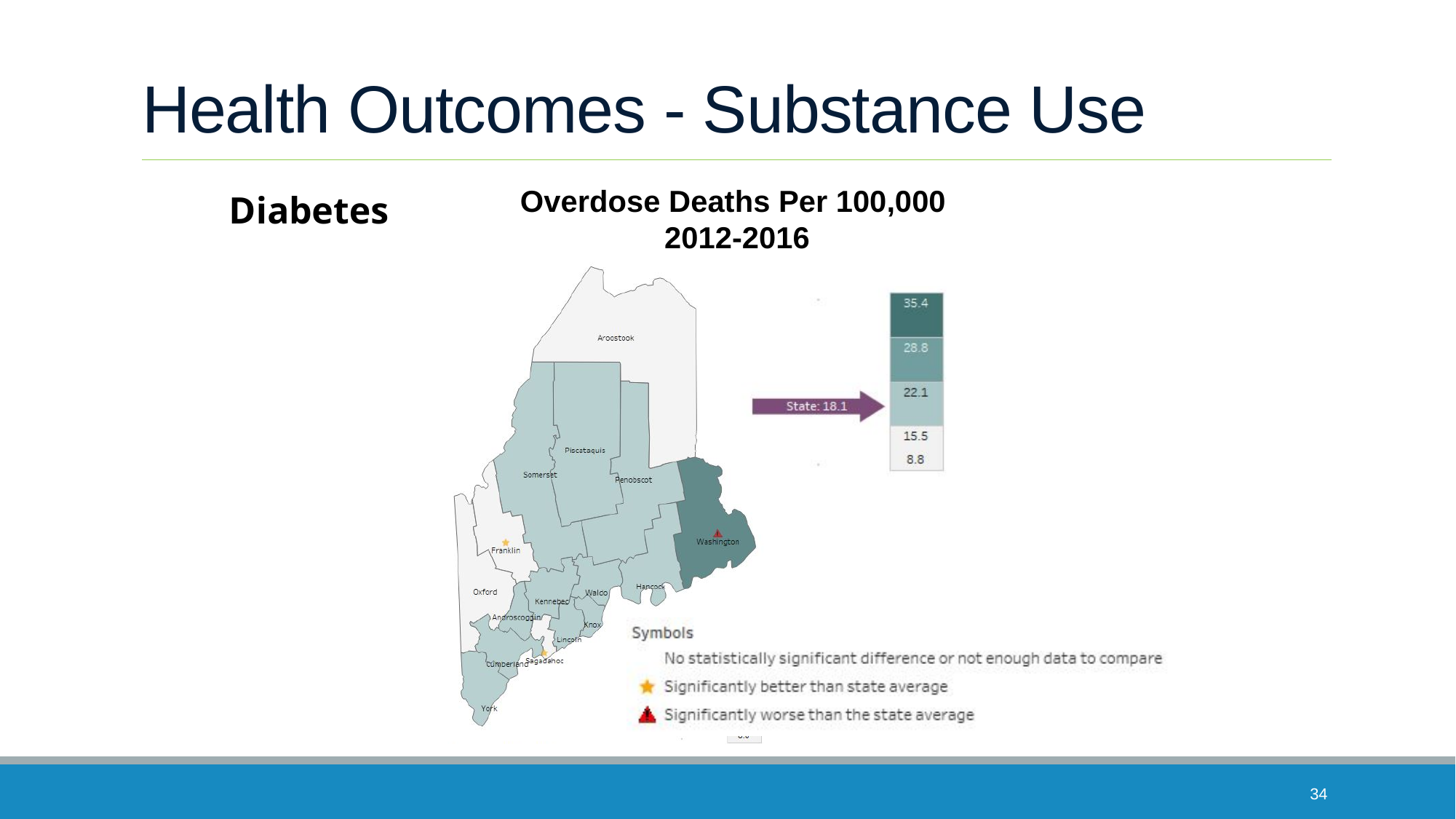
Is the overdose death rate for Washington county greater or less than the state value of 18.1? greater Which county is marked as significantly worse than the state average? Washington What is the title of the map? Overdose Deaths Per 100,000 2012-2016 What time period does the map cover? 2012-2016 What kind of chart is shown on the slide? A map (choropleth map of Maine counties) What is the state value for overdose deaths per 100,000 shown on the map? 18.1 How many values are labelled on the map's colour scale? 5 Which counties are marked with a star as significantly better than the state average? Franklin and Sagadahoc What is the highest value shown on the map's colour scale? 35.4 What is the difference between the highest and lowest values on the map's colour scale? 26.6 What is the lowest value shown on the map's colour scale? 8.8 Which county has the darkest shading, indicating the highest overdose death rate? Washington